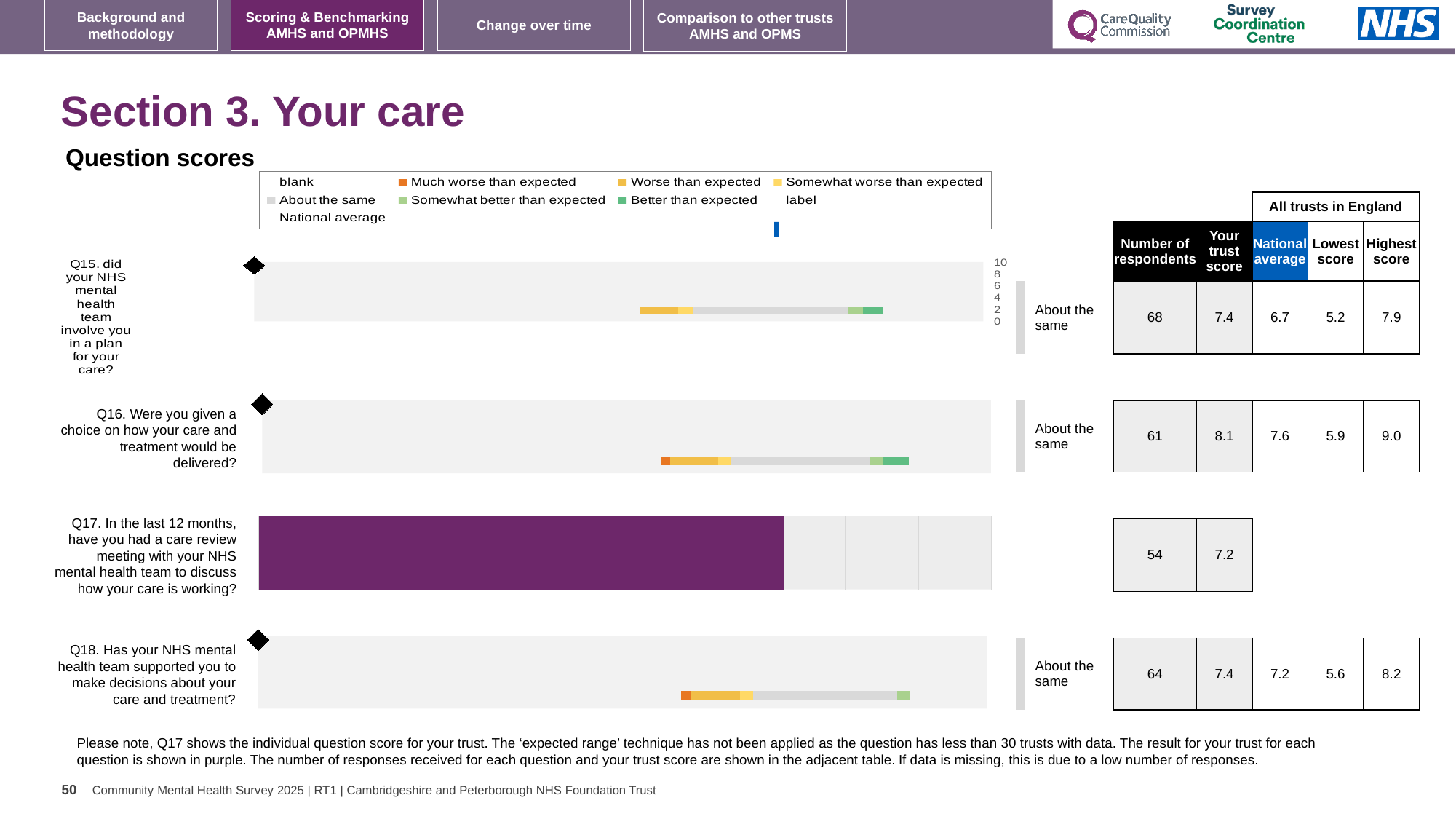
For Q18, which is larger: the trust score or the national average? Trust score (7.4) Which question has the highest trust score? Q16 What colour is the bar for Q17? Purple What kind of chart is used to show the question scores? Bar chart What is the difference between the highest and lowest scores among all trusts in England for Q16? 3.1 What is the lowest score among all trusts in England for Q15? 5.2 What is the difference between the trust score and the national average for Q16? 0.5 How many questions are shown in the Question scores chart? 4 How many respondents answered Q15 (did your NHS mental health team involve you in a plan for your care)? 68 Which question has the lowest number of respondents? Q17 What is the highest score among all trusts in England for Q18? 8.2 What is the trust score for Q16 (Were you given a choice on how your care and treatment would be delivered)? 8.1